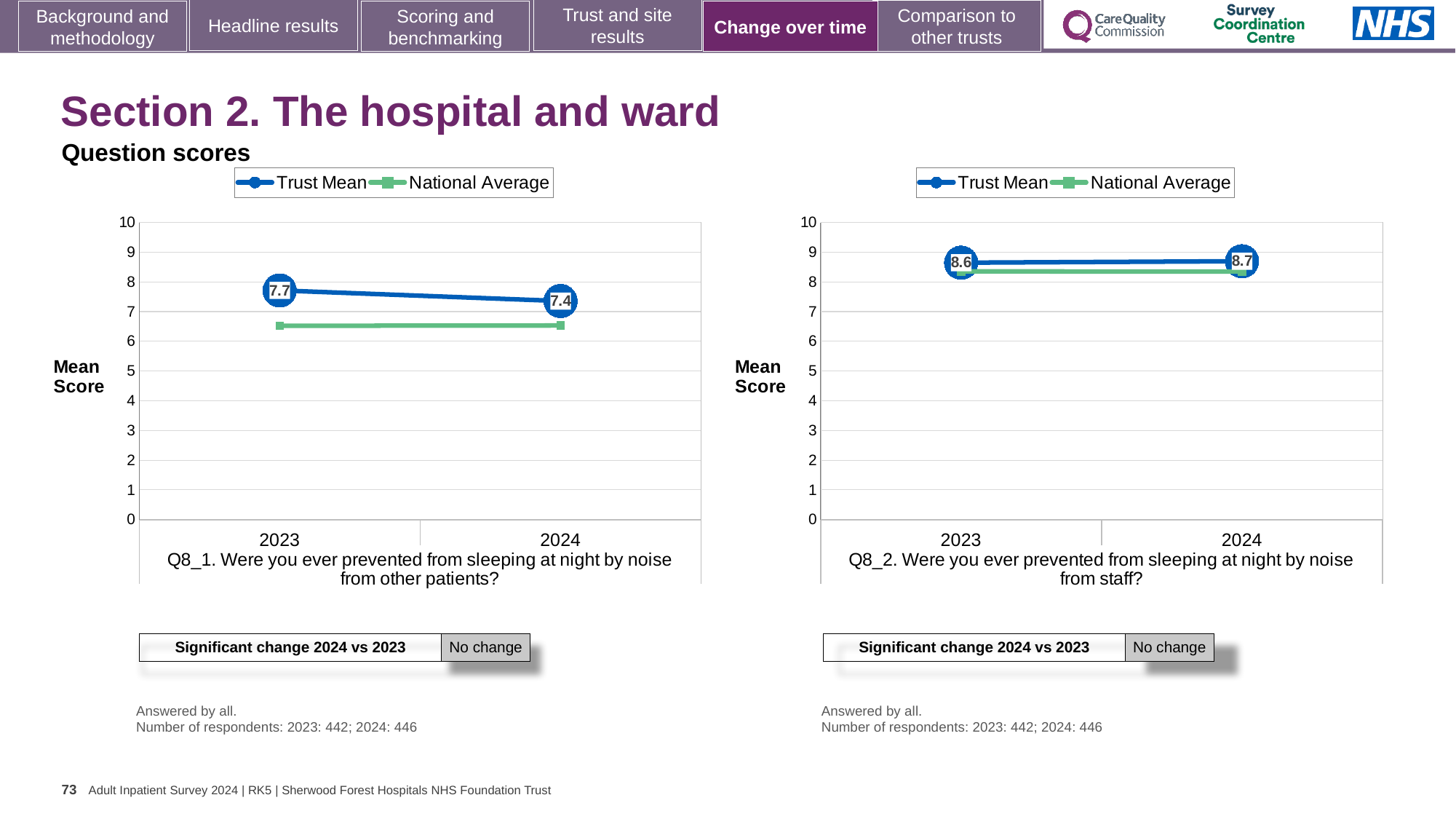
How many series does the legend of the right chart (Q8_2) list? 2 What kind of chart is the left chart (Q8_1)? line chart On the left chart (Q8_1), what is the Trust Mean for 2023? 7.7 On the right chart (Q8_2), is the National Average for 2023 greater or less than 8? greater On the right chart (Q8_2), what is the Trust Mean for 2024? 8.7 On the left chart (Q8_1), what is the Trust Mean for 2024? 7.4 On the left chart (Q8_1), does the Trust Mean rise or fall from 2023 to 2024? fall On the left chart (Q8_1), is the National Average for 2024 greater or less than 7? less On the right chart (Q8_2), what is the Trust Mean for 2023? 8.6 On the right chart (Q8_2), does the Trust Mean rise or fall from 2023 to 2024? rise On the left chart (Q8_1), by how much did the Trust Mean change from 2023 to 2024? 0.3 On the left chart (Q8_1), which is higher in 2024, the Trust Mean or the National Average? Trust Mean